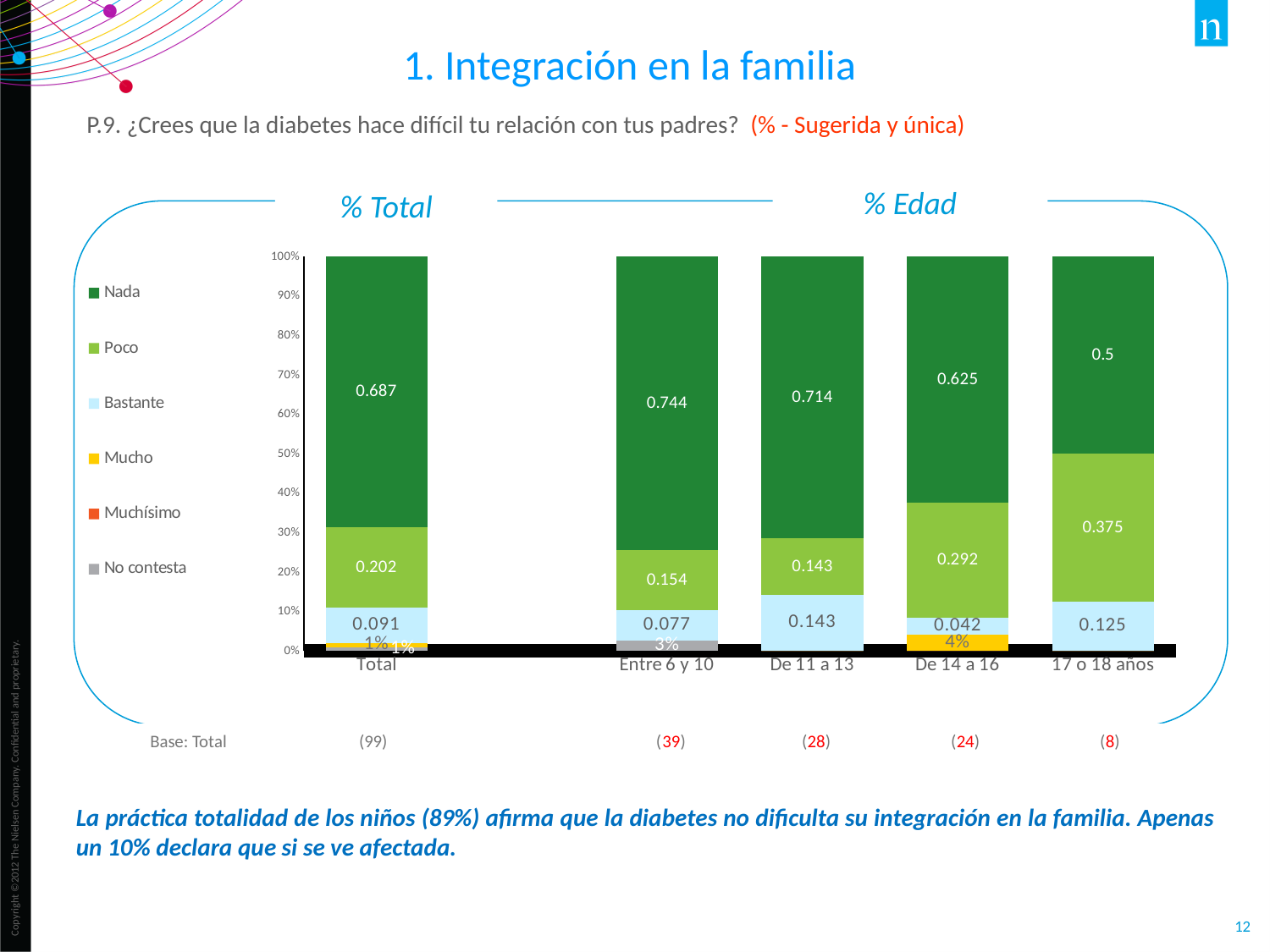
What is the difference between the Nada values for Entre 6 y 10 and 17 o 18 años? 0.244 Which category has the lowest Nada value? 17 o 18 años What is the value of the Nada segment for the Total bar? 0.687 What is the value of the Poco segment for the 17 o 18 años bar? 0.375 Which age group has the highest Nada value? Entre 6 y 10 What is the value of the Bastante segment for De 11 a 13? 0.143 How many categories are shown on the x axis of the chart? 5 How many series does the legend list? 6 What is the value of the Mucho segment for De 14 a 16? 4% What is the value of the Bastante segment for De 14 a 16? 0.042 Does the Nada value rise or fall across the age groups from Entre 6 y 10 to 17 o 18 años? fall Which has a larger Poco value, De 14 a 16 or De 11 a 13? De 14 a 16